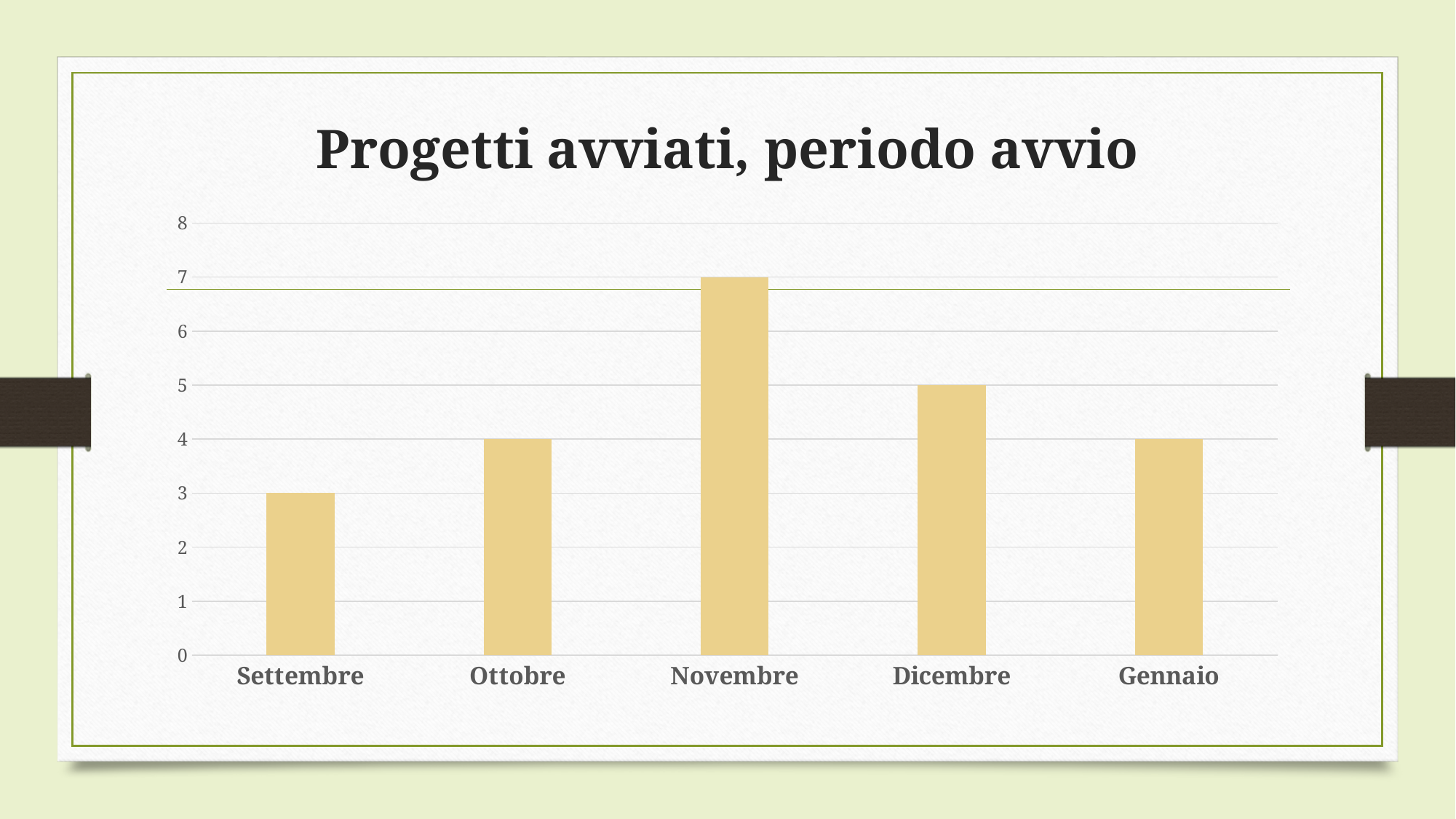
Which month has the highest value? Novembre What is the difference between the values for Novembre and Dicembre? 2 Which is larger, the value for Dicembre or the value for Gennaio? Dicembre What kind of chart is shown on the slide? bar chart Which month has the lowest value? Settembre How many months are shown on the x axis? 5 Do the values rise or fall from Settembre to Novembre? rise What is the value for Dicembre? 5 What is the title of the chart? Progetti avviati, periodo avvio Is the value for Ottobre greater or less than 5? less What is the value for Settembre? 3 What is the value for Novembre? 7